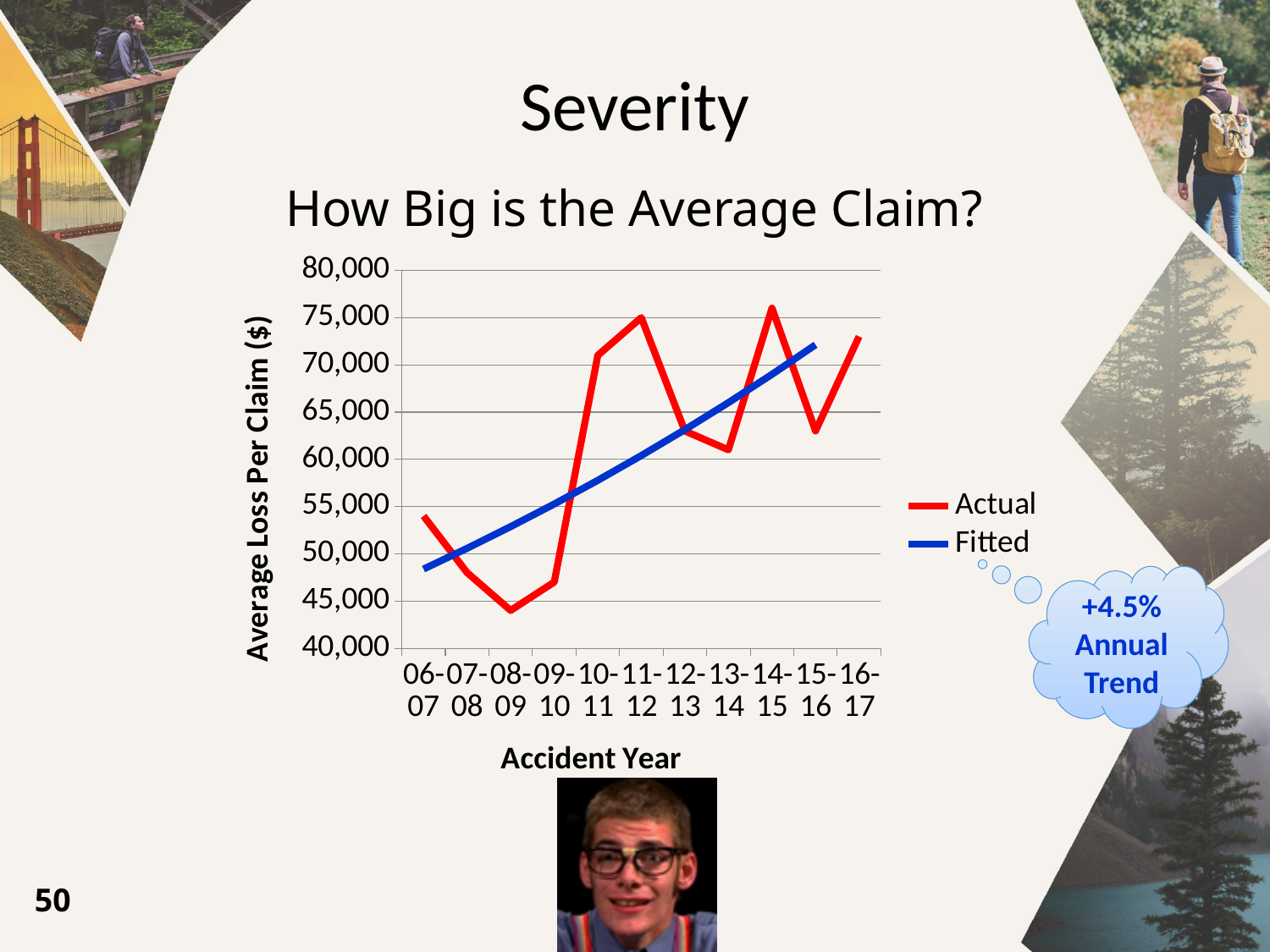
How many accident years are plotted along the x axis? 11 Is the Actual value for accident year 06-07 greater or less than 50,000? greater What kind of chart is shown on the slide? Line chart Is the Actual value for accident year 08-09 greater or less than 45,000? less Which accident year has the lowest Actual average loss per claim? 08-09 Is the Actual value for accident year 13-14 greater or less than 65,000? less What is the title of the y axis? Average Loss Per Claim ($) Does the Fitted line rise or fall across the accident years? Rises Which is larger, the Actual value for 10-11 or the Actual value for 07-08? 10-11 How many series does the chart legend list? 2 What annual trend percentage is shown in the callout next to the chart? +4.5%